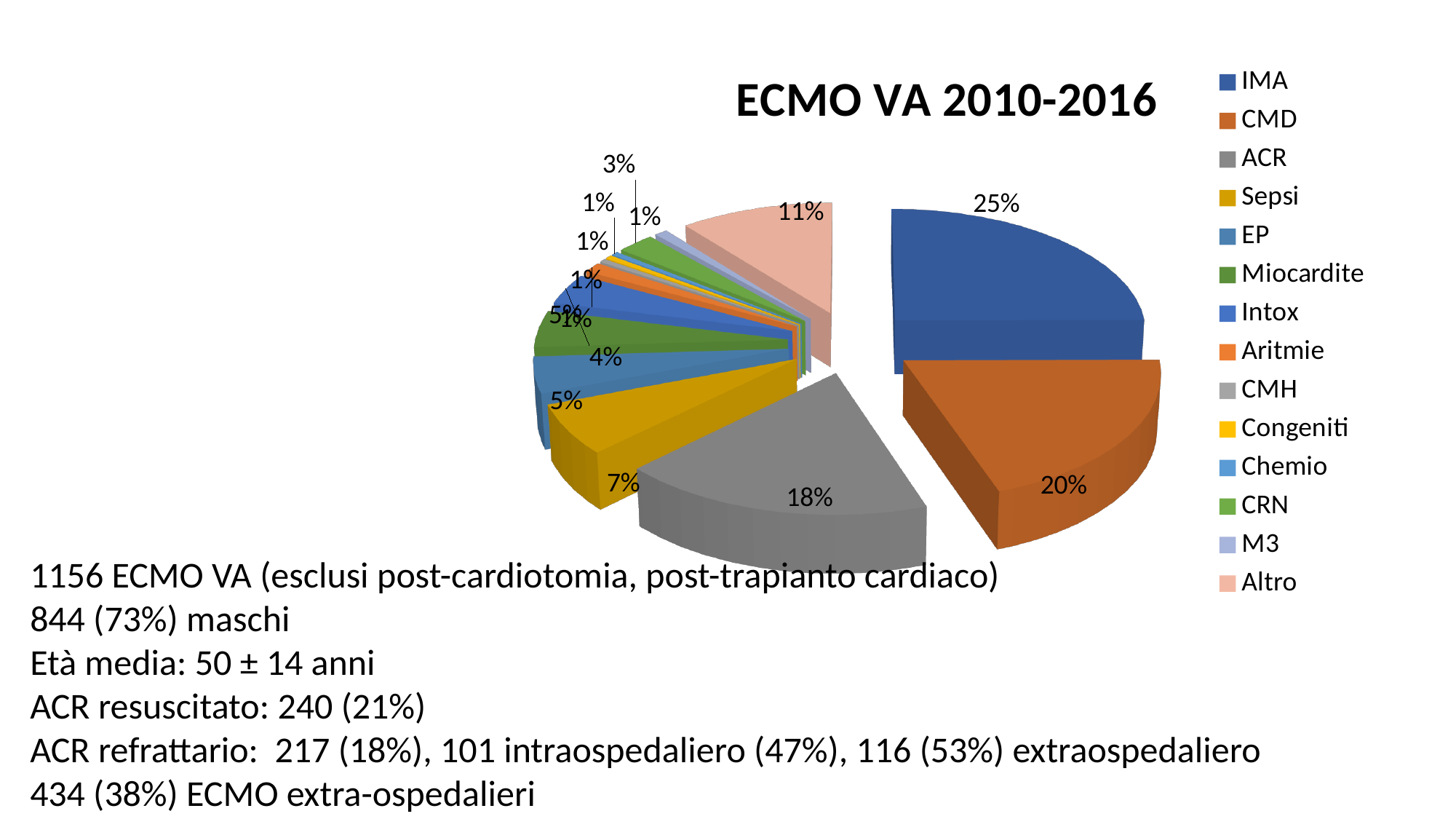
What share of the pie does Miocardite represent? 5% What is the title of the chart? ECMO VA 2010-2016 What share of the pie does Altro represent? 11% What share of the pie does Sepsi represent? 7% How many categories does the legend of the pie chart list? 14 What kind of chart is shown on the slide? Pie chart Which slice is larger, ACR or Altro? ACR By how many percentage points does the IMA share exceed the CMD share? 5 percentage points Which category has the largest slice of the pie? IMA